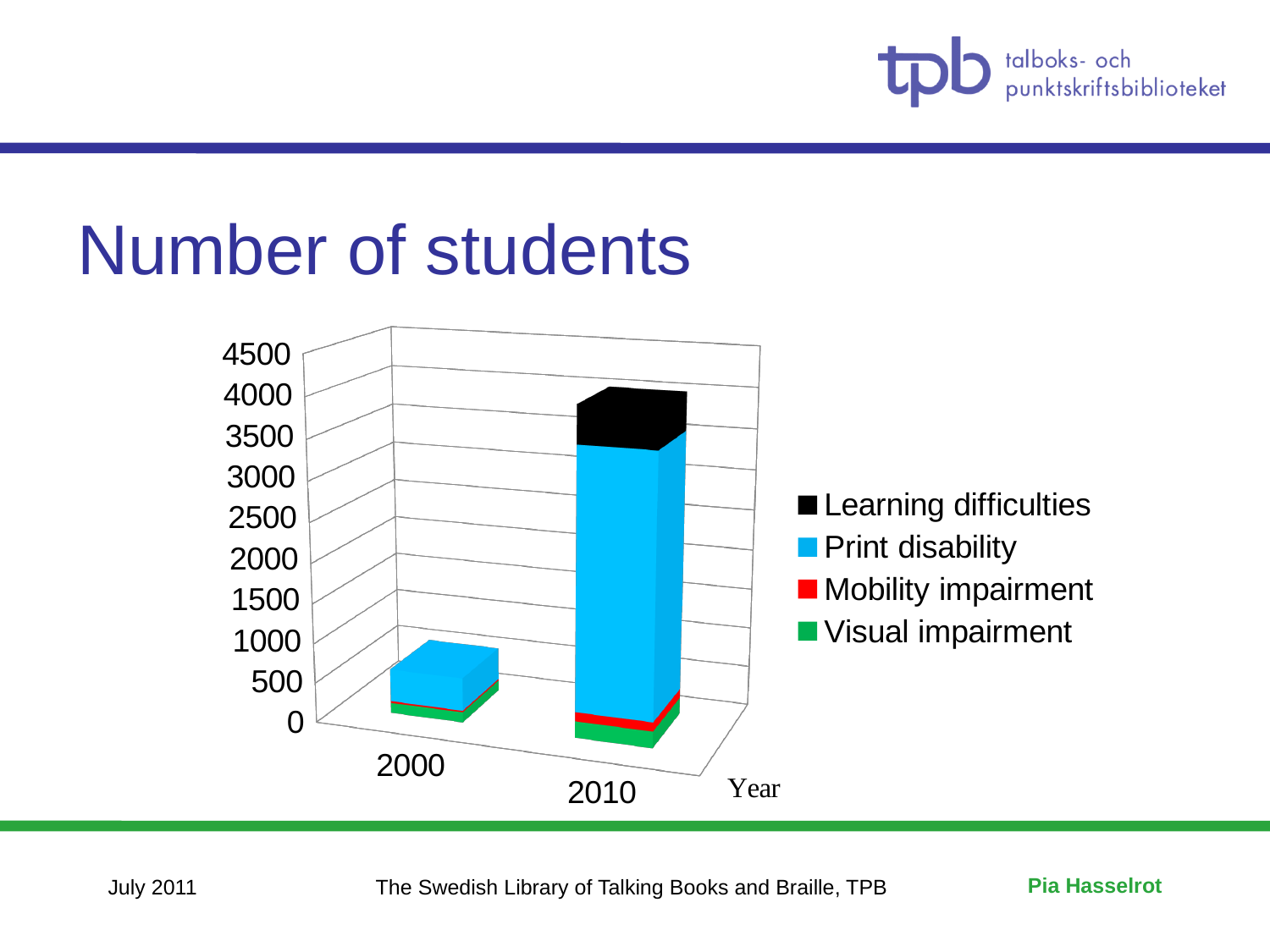
Which series makes up the largest part of the 2010 bar? Print disability How many years are shown on the x axis of the chart? 2 Is the Print disability segment larger in 2000 or in 2010? 2010 What is the title of the chart? Number of students Is the total number of students in 2000 greater or less than 1000? less Which year has the lower total number of students? 2000 Is the total number of students in 2010 greater or less than 3000? greater Which series is shown in black in the legend? Learning difficulties Does the total number of students rise or fall from 2000 to 2010? rise Which year has the higher total number of students? 2010 How many series does the chart's legend list? 4 What kind of chart is shown on the slide? Stacked bar chart